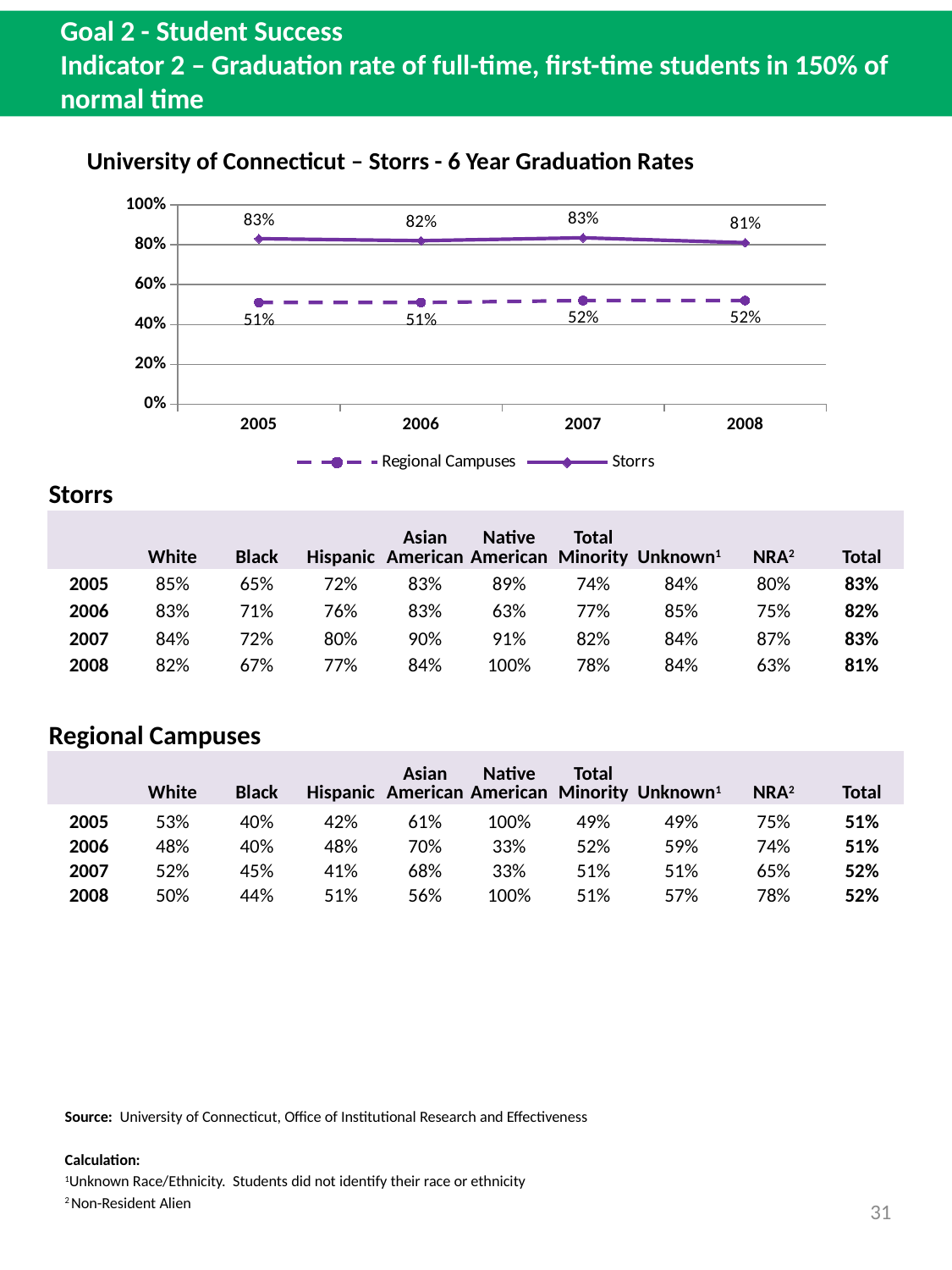
Is the Regional Campuses value for 2007 greater or less than 60%? less What is the difference between the Storrs and Regional Campuses graduation rates in 2006? 31% What kind of chart is shown on the slide? Line chart Does the Regional Campuses graduation rate rise or fall from 2005 to 2008? Rises Which series has the higher graduation rate in 2008, Storrs or Regional Campuses? Storrs What is the Regional Campuses graduation rate for 2005? 51% How many years are shown on the x axis of the chart? 4 How many series does the chart legend list? 2 In which year is the Storrs graduation rate lowest? 2008 What is the title of the chart? University of Connecticut – Storrs - 6 Year Graduation Rates What is the Storrs 6-year graduation rate for 2007? 83% What is the Storrs graduation rate for 2008? 81%